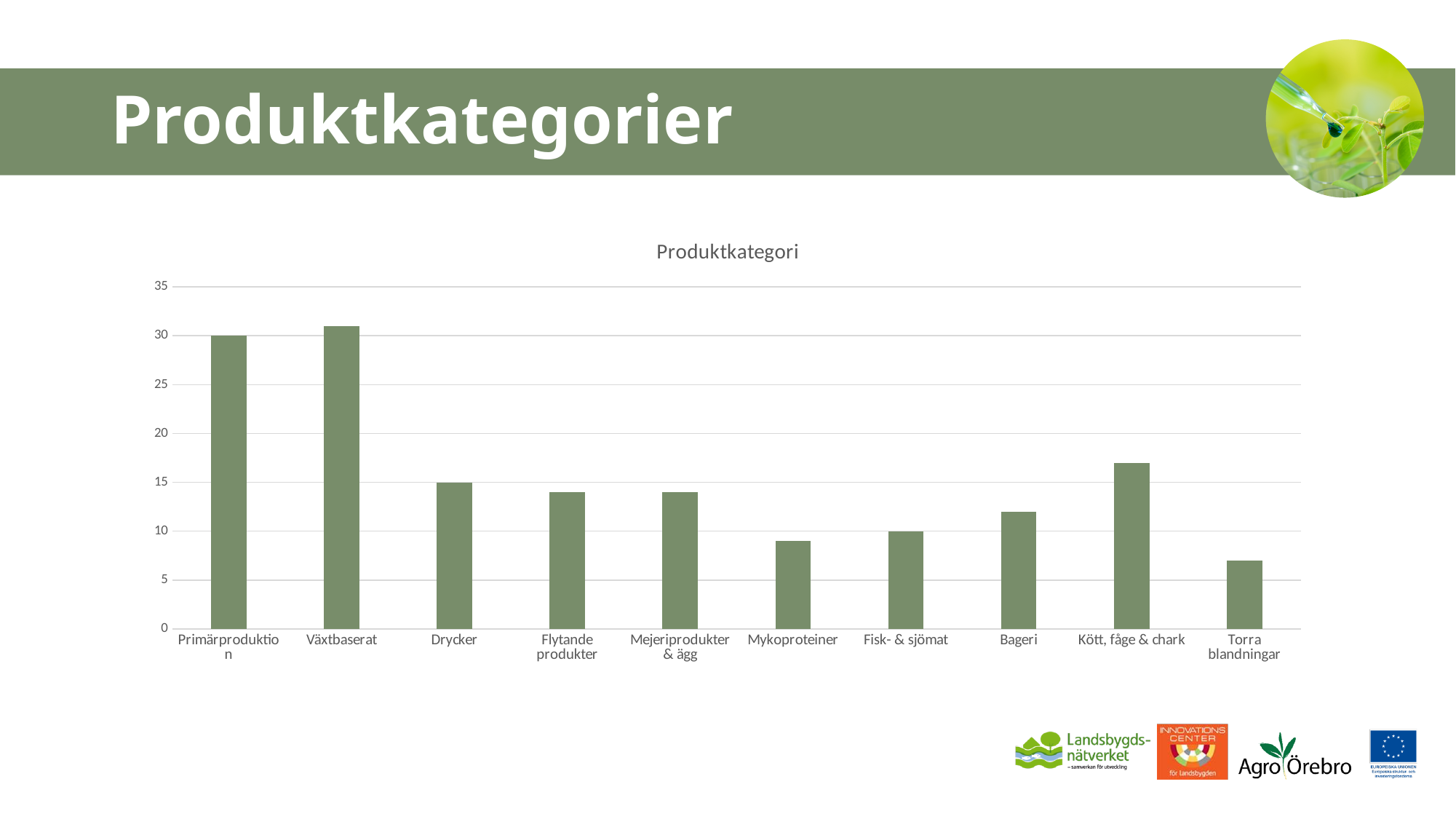
Is the value for Mykoproteiner greater or less than 10? less What is the value for Drycker? 15 How many product categories are shown on the x axis? 10 Is the value for Torra blandningar greater or less than 10? less Is the value for Bageri greater or less than 10? greater What is the value for Fisk- & sjömat? 10 Which is larger, the value for Drycker or the value for Mykoproteiner? Drycker Which is larger, the value for Kött, fåge & chark or the value for Bageri? Kött, fåge & chark What is the title of the chart? Produktkategori Which category has the lowest value? Torra blandningar What kind of chart is shown on the slide? bar chart